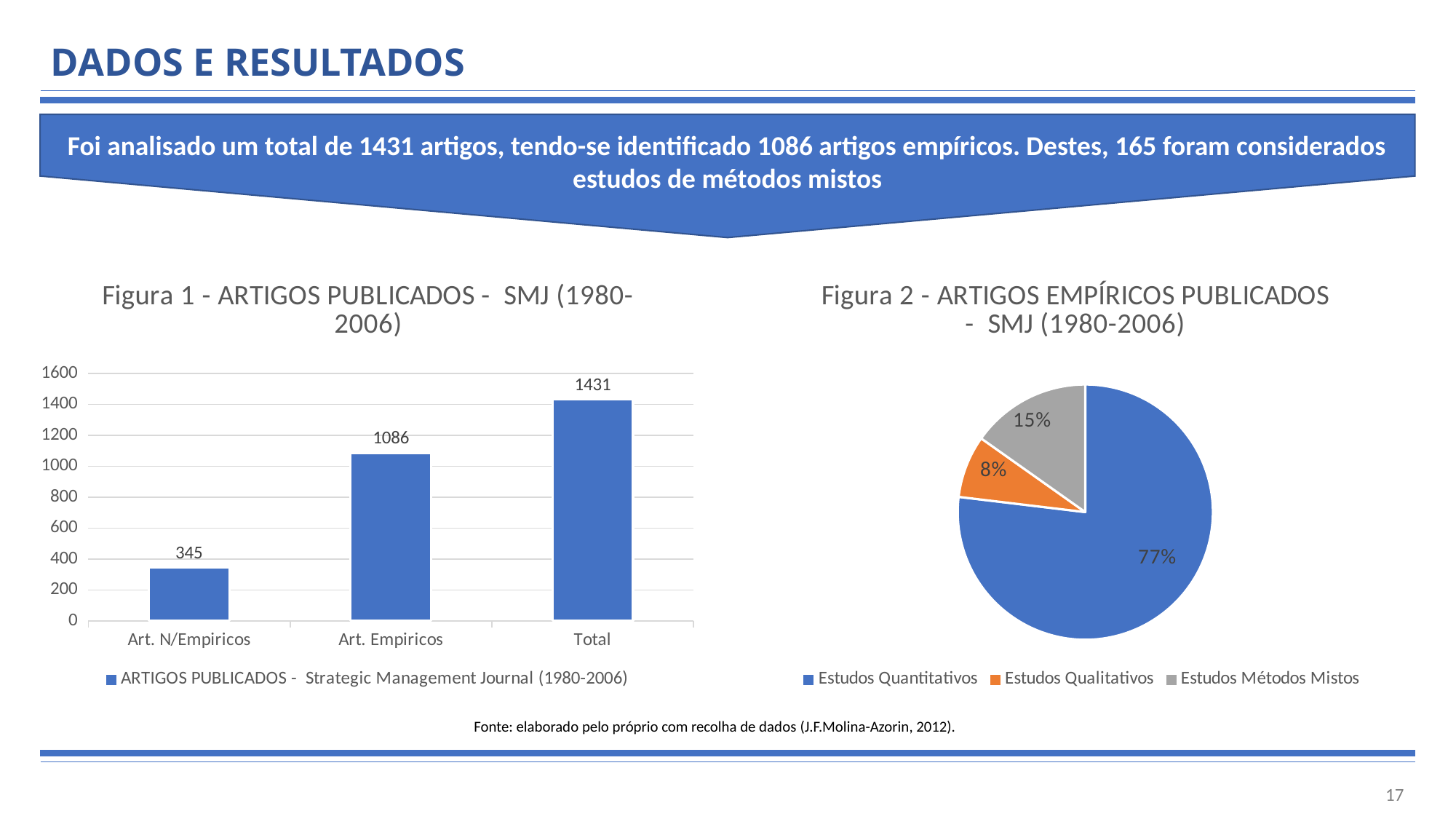
In Figura 1, is the value for Art. Empiricos greater or less than 1000? greater In Figura 1, which category has the highest value? Total In Figura 2, which slice is the smallest? Estudos Qualitativos In Figura 1, what is the value for Art. Empiricos? 1086 How many series does the legend of Figura 2 list? 3 In Figura 1, which category has the lowest value? Art. N/Empiricos What kind of chart is Figura 1? bar chart In Figura 1, what is the difference between Total and Art. Empiricos? 345 In Figura 1, how many categories are shown on the x axis? 3 In Figura 2, what share of the pie is Estudos Quantitativos? 77% In Figura 1, what is the value for Art. N/Empiricos? 345 In Figura 2, what share of the pie is Estudos Métodos Mistos? 15%